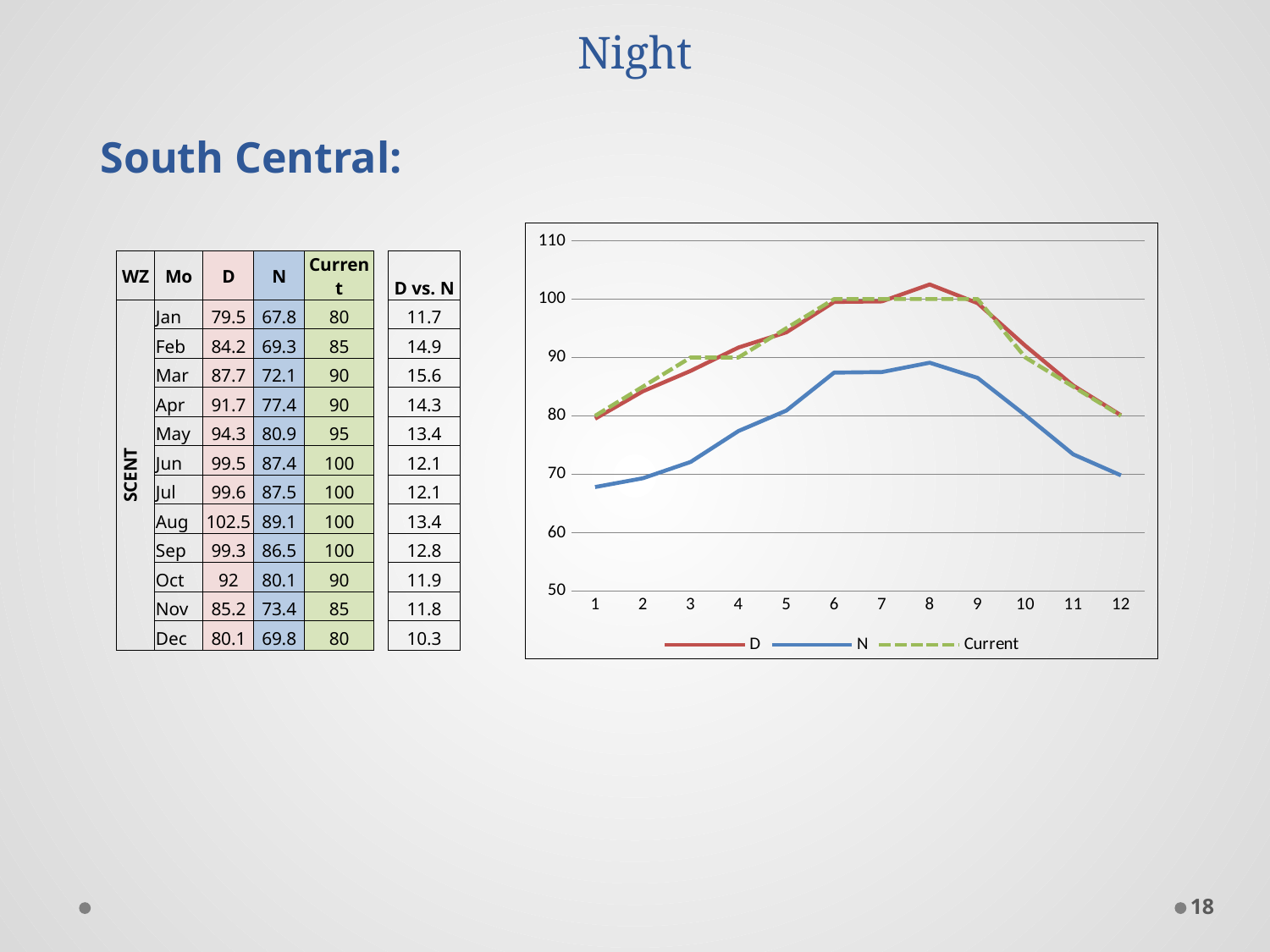
Does the D series rise or fall from x = 1 to x = 8? rise What kind of chart is shown on the slide? line chart Is the value of the D series at x = 8 greater or less than 100? greater How many series does the chart legend list? 3 Is the value of the N series at x = 1 greater or less than 70? less According to the table on the slide, what is the D value for Aug (point 8 on the chart)? 102.5 At which x-axis point does the D series reach its highest value? 8 At x = 6, which series is higher, D or N? D How many points are there along the x axis of the chart? 12 Which series in the chart is drawn with a dashed line? Current Is the value of the N series at x = 8 greater or less than 90? less What are the three series names in the chart legend? D, N, Current